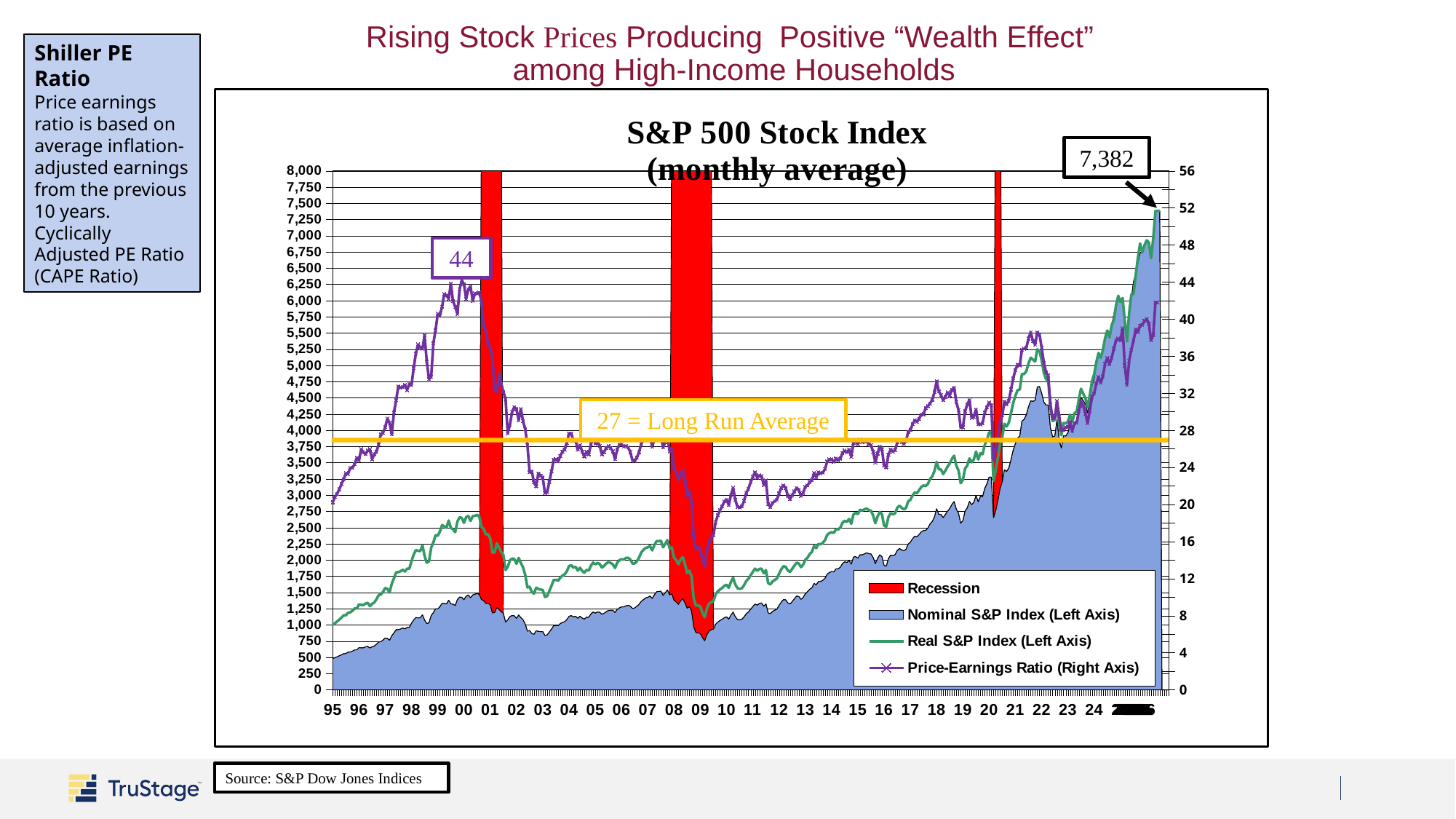
What is the labeled peak value of the Price-Earnings Ratio around 2000? 44 At the end of the series, is the Price-Earnings Ratio greater or less than 36? greater How many recession periods are shaded on the chart? 3 What is the labeled latest value of the Nominal S&P Index? 7,382 How many series does the legend list? 4 Is the Nominal S&P Index in 1995 greater or less than 1,000? less Does the Nominal S&P Index generally rise or fall from 1995 to the end of the series? rise On which axis is the Price-Earnings Ratio plotted? Right axis What value is labeled as the long run average of the Price-Earnings Ratio? 27 How much higher is the labeled peak Price-Earnings Ratio of 44 than the long run average of 27? 17 What is the title of the chart? S&P 500 Stock Index (monthly average) At its lowest point around 2009, is the Price-Earnings Ratio greater or less than 20? less